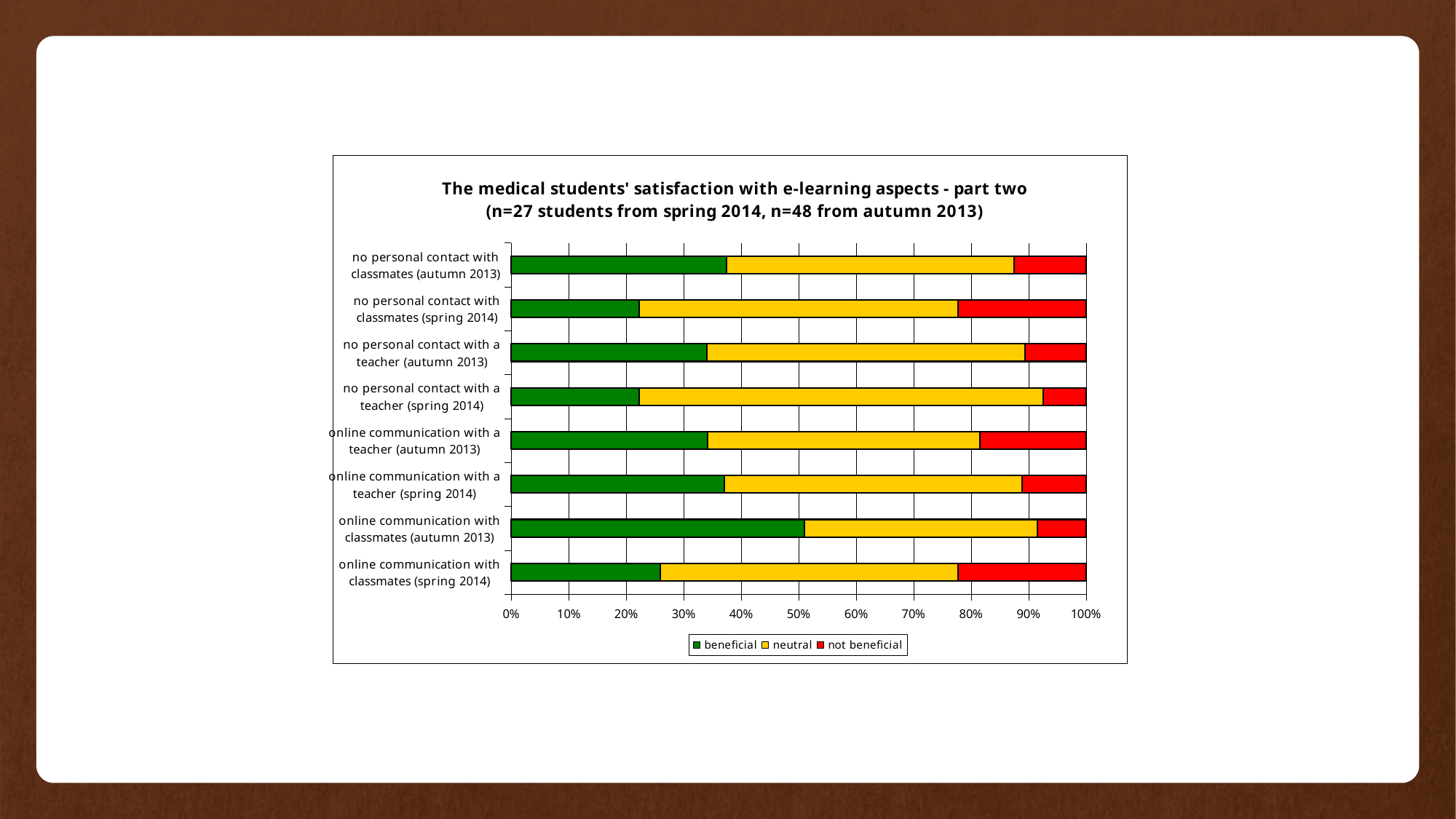
What is the title of the chart? The medical students' satisfaction with e-learning aspects - part two (n=27 students from spring 2014, n=48 from autumn 2013) What kind of chart is shown on the slide? bar chart Which category has the largest 'beneficial' share? online communication with classmates (autumn 2013) Is the 'beneficial' share for no personal contact with classmates (autumn 2013) greater or less than 30%? greater How many series does the legend list? 3 What colour represents the 'not beneficial' series in the chart? red How many categories (bars) does the chart show? 8 Is the 'beneficial' share for online communication with classmates (autumn 2013) greater or less than 40%? greater Is the 'beneficial' share for no personal contact with classmates (spring 2014) greater or less than 30%? less Which has the larger 'beneficial' share: no personal contact with classmates (autumn 2013) or no personal contact with classmates (spring 2014)? no personal contact with classmates (autumn 2013) Which has the larger 'beneficial' share: online communication with classmates (autumn 2013) or online communication with classmates (spring 2014)? online communication with classmates (autumn 2013)